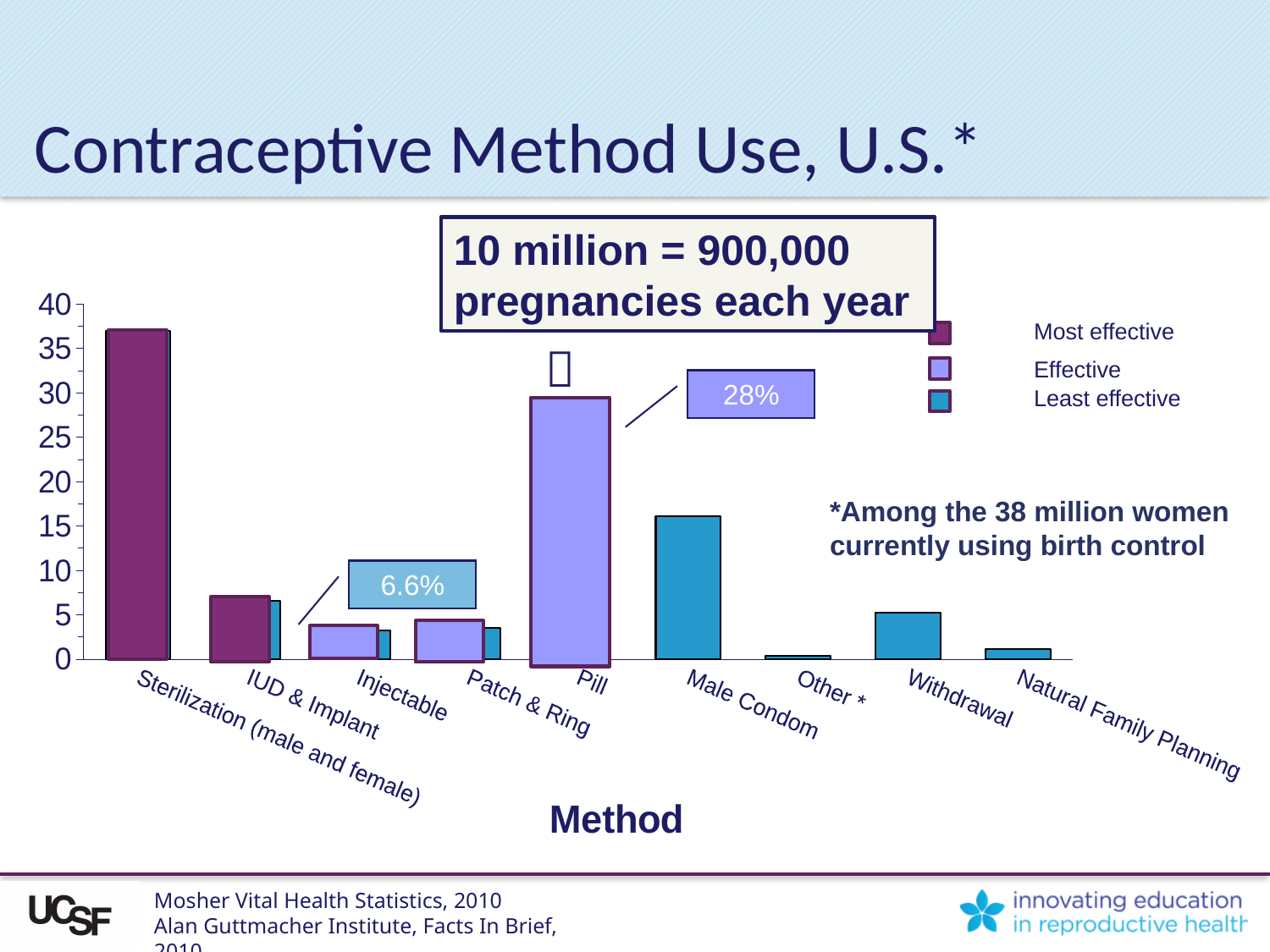
How many contraceptive methods are shown along the x axis? 9 Is the value for Sterilization (male and female) greater or less than 35? greater What is the title of the x axis? Method How many entries does the legend list? 3 Which method has the lowest bar? Other * Which has a higher value, Pill or Male Condom? Pill What kind of chart is shown on the slide? bar chart Which has a higher value, Sterilization (male and female) or Pill? Sterilization (male and female) Is the value for Withdrawal greater or less than 10? less Is the value for Pill greater or less than 25? greater Which method has the highest bar? Sterilization (male and female)